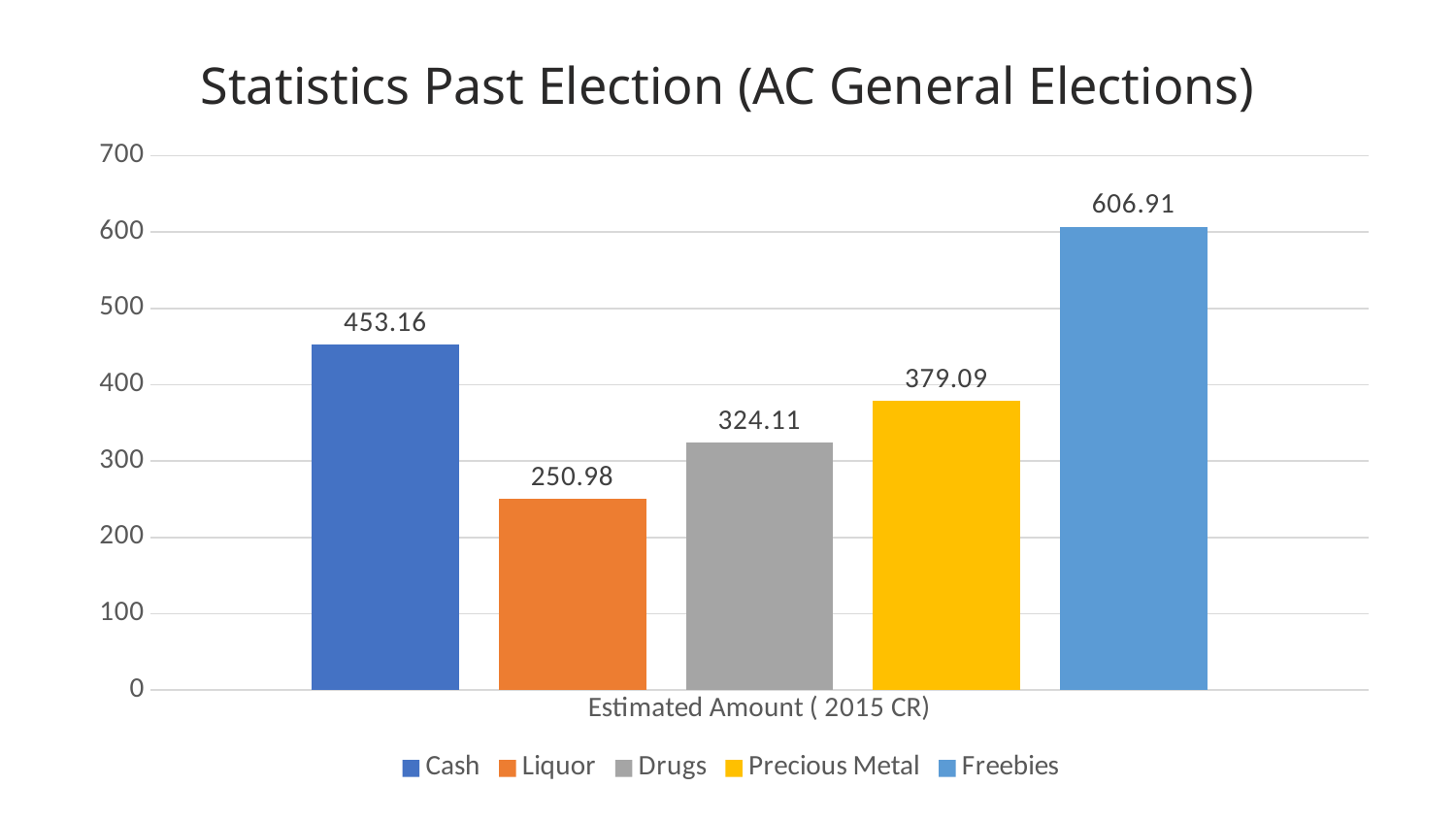
What kind of chart is shown on the slide? Bar chart What is the estimated amount for Precious Metal? 379.09 What is the estimated amount for Liquor? 250.98 What is the title of the chart? Statistics Past Election (AC General Elections) Which category has the highest estimated amount? Freebies What is the difference between the estimated amounts for Drugs and Liquor? 73.13 Which category has the lowest estimated amount? Liquor What is the difference between the estimated amounts for Freebies and Cash? 153.75 What is the estimated amount for Cash? 453.16 How many series does the legend list? 5 Is the value for Freebies greater or less than 600? greater Which is larger, the estimated amount for Drugs or for Precious Metal? Precious Metal